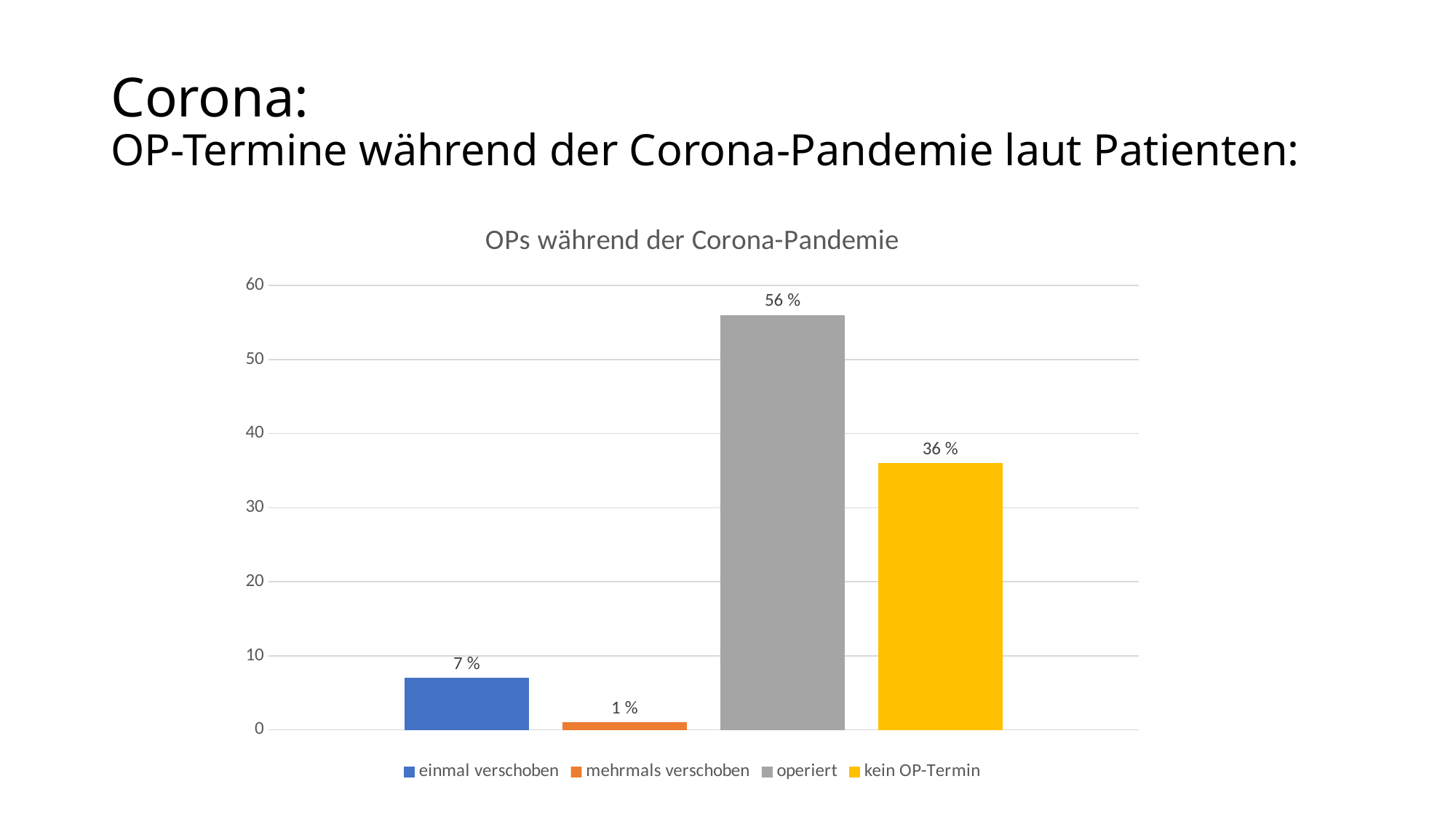
Which is larger, the value for "einmal verschoben" or the value for "mehrmals verschoben"? einmal verschoben What is the difference between the values for "operiert" and "kein OP-Termin"? 20 % How many categories are shown in the chart? 4 Which category has the highest value? operiert Which category has the lowest value? mehrmals verschoben What is the value for "kein OP-Termin"? 36 % What kind of chart is shown on the slide? bar chart What is the value for "mehrmals verschoben"? 1 % What is the value for "einmal verschoben"? 7 % Is the value for "kein OP-Termin" greater or less than 40? less What is the title of the chart? OPs während der Corona-Pandemie What is the value for "operiert"? 56 %